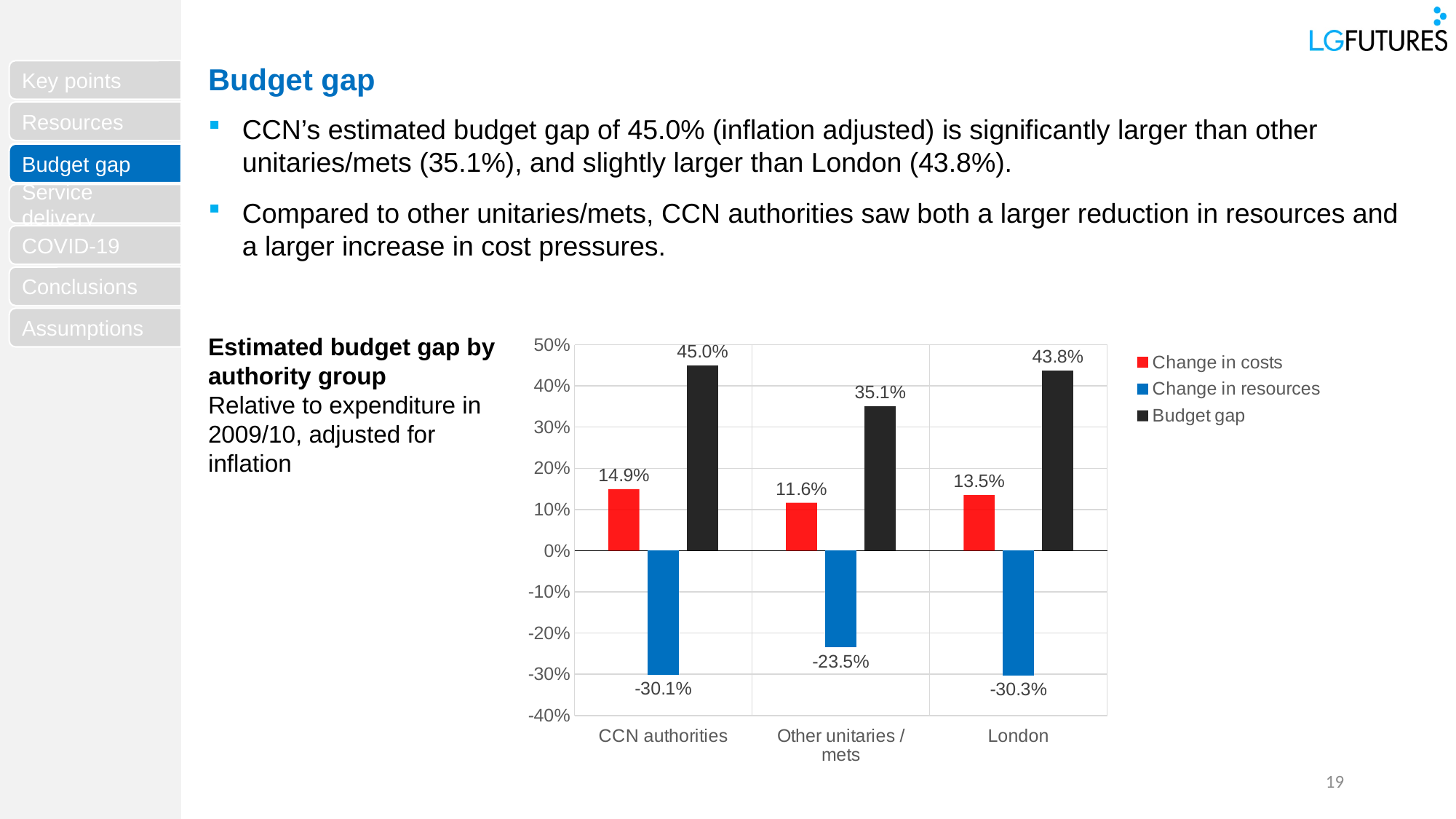
Which colour represents Change in resources in the chart? Blue What is the difference between the Budget gap for CCN authorities and Other unitaries / mets? 9.9% How many authority groups are shown on the x axis? 3 Which authority group has the highest Budget gap? CCN authorities Which is larger, the Change in costs for CCN authorities or for London? CCN authorities What is the Change in resources value for Other unitaries / mets? -23.5% What is the Change in costs value for London? 13.5% How many series does the legend list? 3 What kind of chart is shown on the slide? Bar chart Which authority group has the lowest Change in costs? Other unitaries / mets Is the Budget gap for London greater or less than 40%? greater What is the Budget gap value for CCN authorities? 45.0%